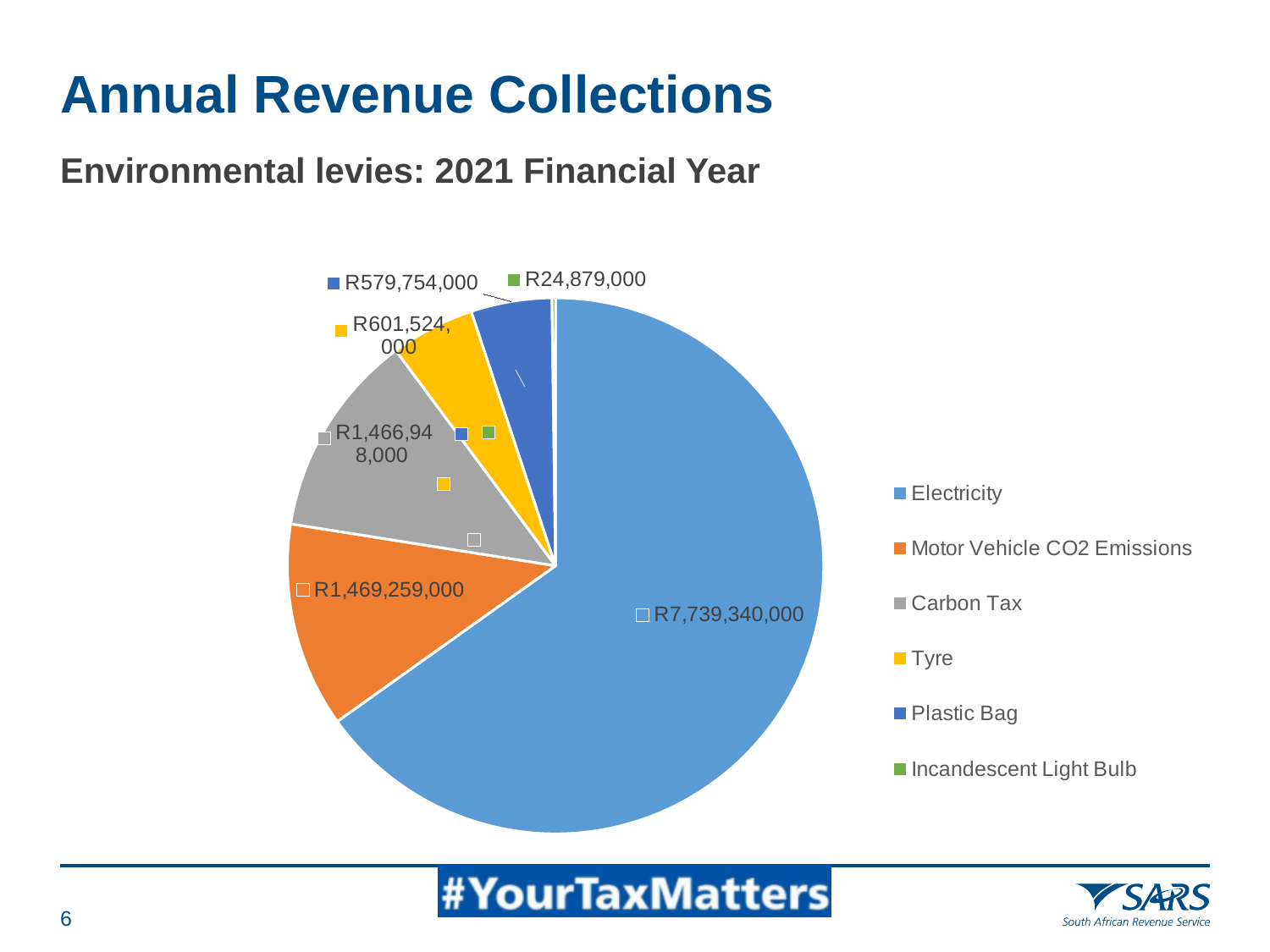
What is the value for Carbon Tax? R1,466,948,000 Which is larger, the value for Tyre or the value for Plastic Bag? Tyre What is the difference between the value for Motor Vehicle CO2 Emissions and the value for Carbon Tax? R2,311,000 What is the value for Incandescent Light Bulb? R24,879,000 What is the value for Electricity? R7,739,340,000 What is the difference between the value for Tyre and the value for Plastic Bag? R21,770,000 What is the subtitle of the chart on the slide? Environmental levies: 2021 Financial Year What is the value for Plastic Bag? R579,754,000 How many categories does the legend list? 6 Which category has the largest slice of the pie? Electricity Which category has the smallest slice of the pie? Incandescent Light Bulb What type of chart is shown on the slide? Pie chart